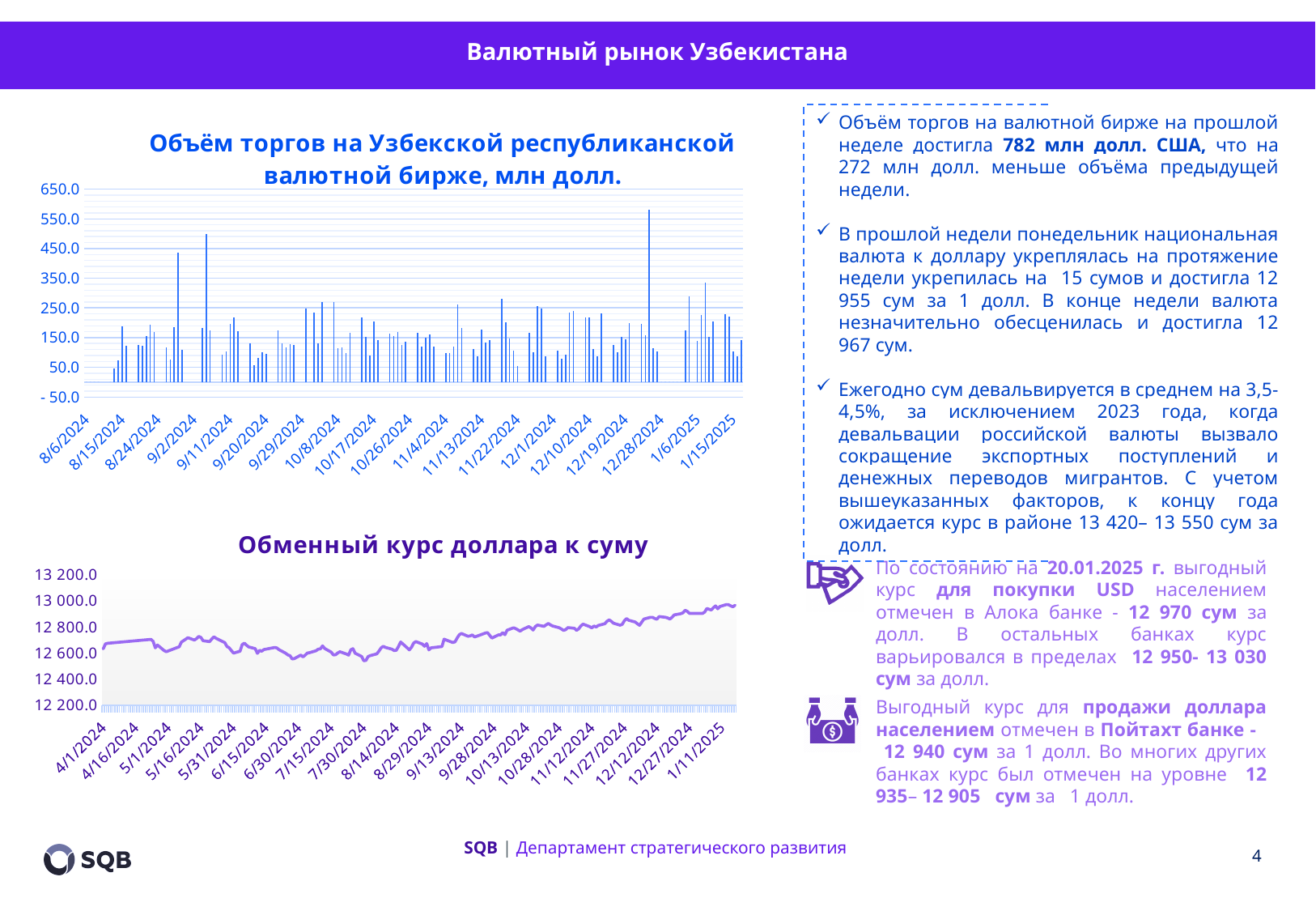
In the top chart of trading volume, is the tall bar near 9/11/2024 greater or less than 450? greater How many charts are shown on the slide? 2 In the top chart of trading volume, is the tallest bar (near 12/28/2024) greater or less than 550? greater In the bottom chart "Обменный курс доллара к суму", does the exchange rate generally rise or fall from April 2024 to January 2025? rise In the bottom chart "Обменный курс доллара к суму", is the exchange rate higher at the start of the series (4/1/2024) or at the end (1/11/2025)? at the end (1/11/2025) What is the lowest tick value on the y-axis of the bottom chart "Обменный курс доллара к суму"? 12 200.0 What is the highest tick value on the y-axis of the top chart of trading volume? 650.0 In the bottom chart "Обменный курс доллара к суму", is the value in January 2025 greater or less than 12 800.0? greater What kind of chart is the top chart titled "Объём торгов на Узбекской республиканской валютной бирже, млн долл."? bar chart What kind of chart is the bottom chart titled "Обменный курс доллара к суму"? line chart